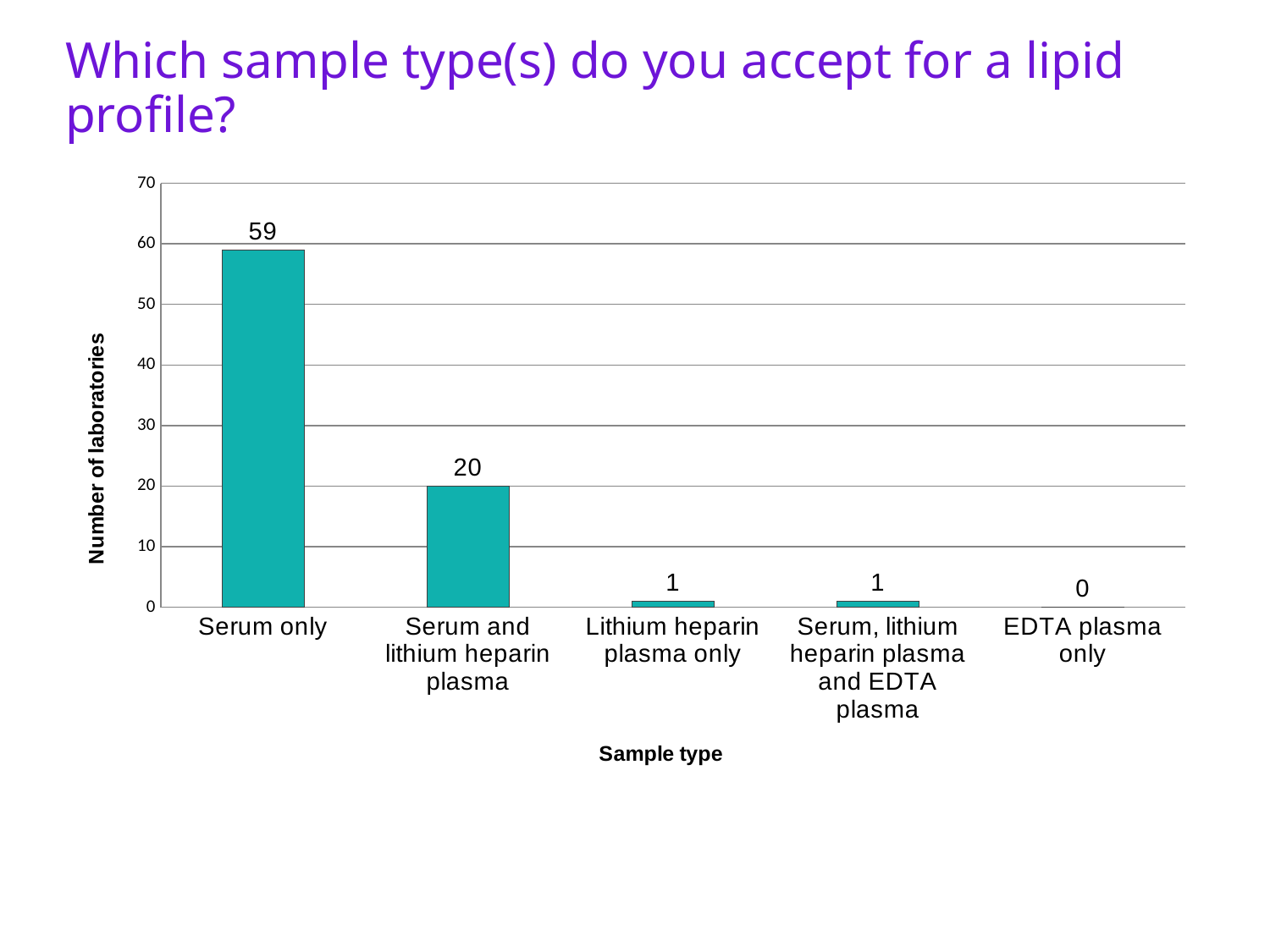
Which sample type has the highest number of laboratories? Serum only How many sample type categories are shown on the x axis? 5 Which has more laboratories: 'Serum and lithium heparin plasma' or 'Lithium heparin plasma only'? Serum and lithium heparin plasma How many laboratories accept serum only for a lipid profile? 59 What is the difference between the number of laboratories for 'Serum only' and 'Serum and lithium heparin plasma'? 39 What is the number of laboratories for 'Serum and lithium heparin plasma'? 20 What is the value shown for 'Lithium heparin plasma only'? 1 Which sample type has the lowest number of laboratories? EDTA plasma only Is the value for 'Serum only' greater or less than 50? greater What is the value shown for 'EDTA plasma only'? 0 What kind of chart is shown on the slide? Bar chart What is the label of the y axis? Number of laboratories